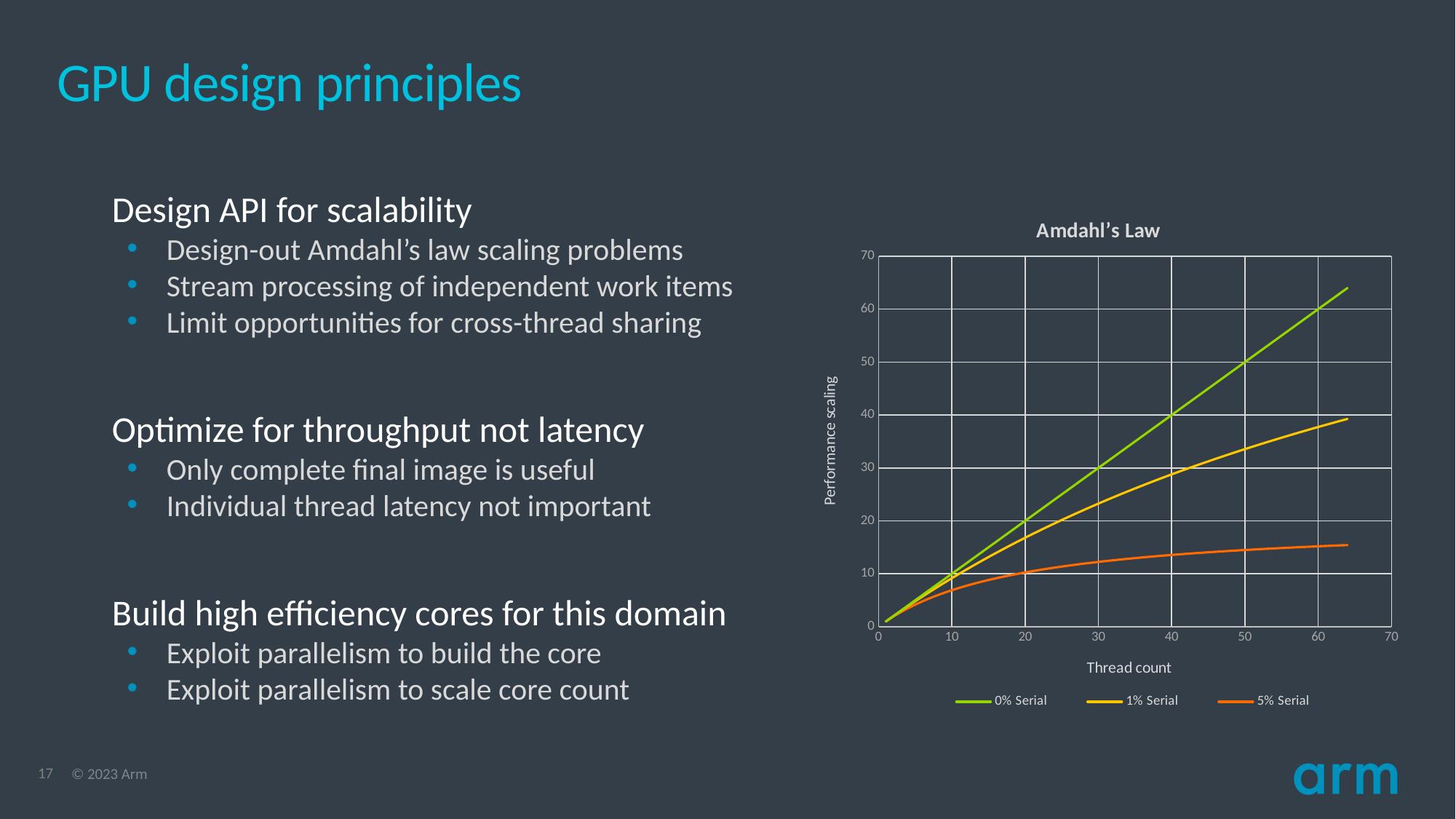
What are the three series listed in the chart legend? 0% Serial, 1% Serial, 5% Serial At a thread count of 60, which series has the higher performance scaling, 1% Serial or 5% Serial? 1% Serial How many series does the chart legend list? 3 At a thread count of 40, is the performance scaling for 5% Serial greater or less than 10? greater Does the performance scaling for the 5% Serial series rise or fall as thread count increases? rise What kind of chart is shown on the slide? line chart At the highest thread count plotted, is the performance scaling for 1% Serial greater or less than 30? greater Which series has the lowest performance scaling at the highest thread count plotted? 5% Serial Which series reaches the highest performance scaling at the right end of the chart? 0% Serial At the highest thread count plotted, is the performance scaling for 5% Serial greater or less than 20? less What is the title of the chart? Amdahl's Law